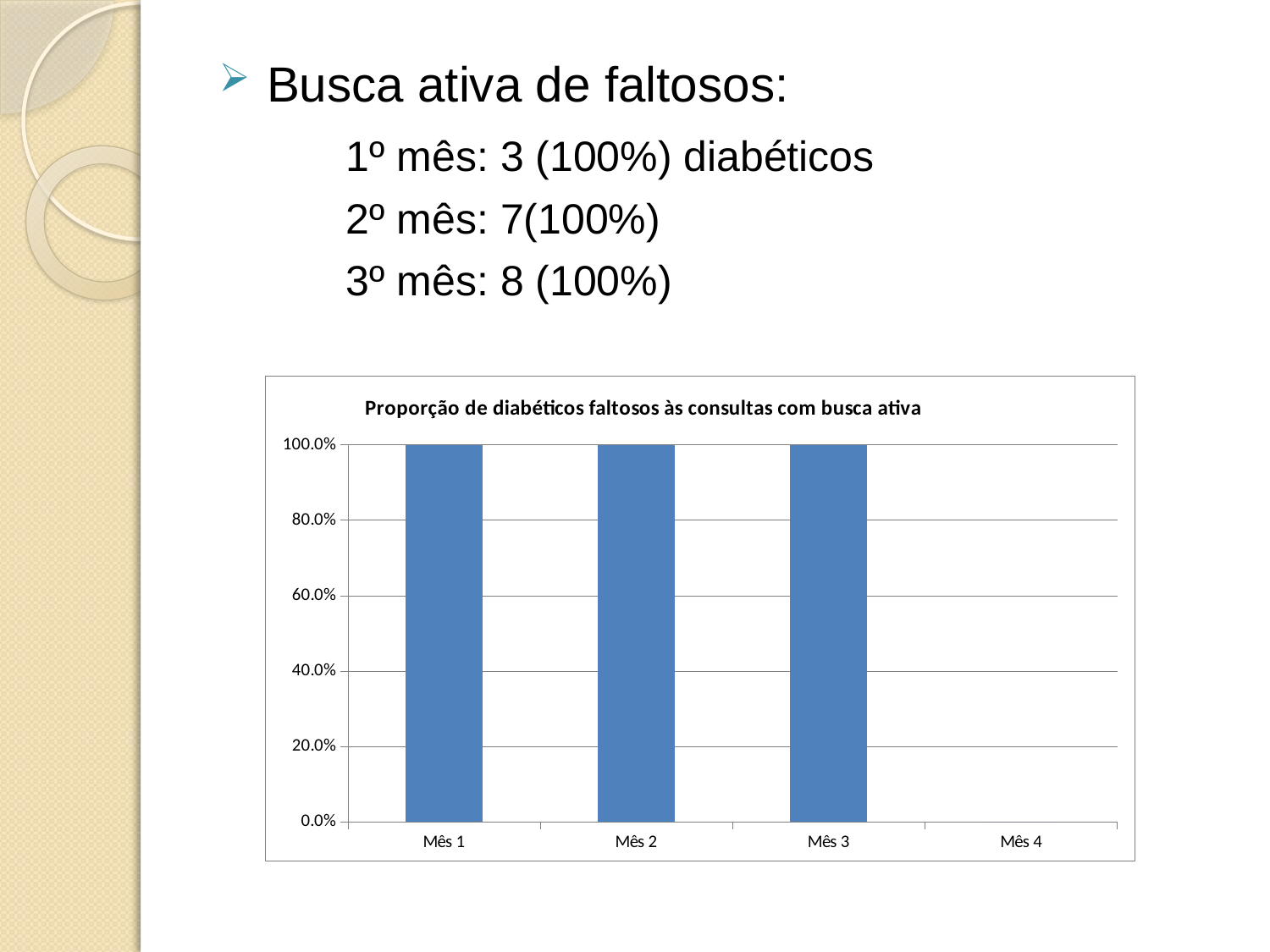
What is the title of the chart? Proporção de diabéticos faltosos às consultas com busca ativa What is the value for Mês 1? 100.0% Do the values rise, fall or stay the same from Mês 1 to Mês 3? stay the same How many bars are plotted in the chart? 3 What is the highest tick value shown on the y axis? 100.0% What is the value for Mês 3? 100.0% What is the value for Mês 2? 100.0% Which category has no bar plotted? Mês 4 How many categories are shown on the x axis? 4 What is the difference between the values for Mês 1 and Mês 3? 0.0% Is the value for Mês 2 greater or less than 80.0%? greater What type of chart is shown on the slide? bar chart